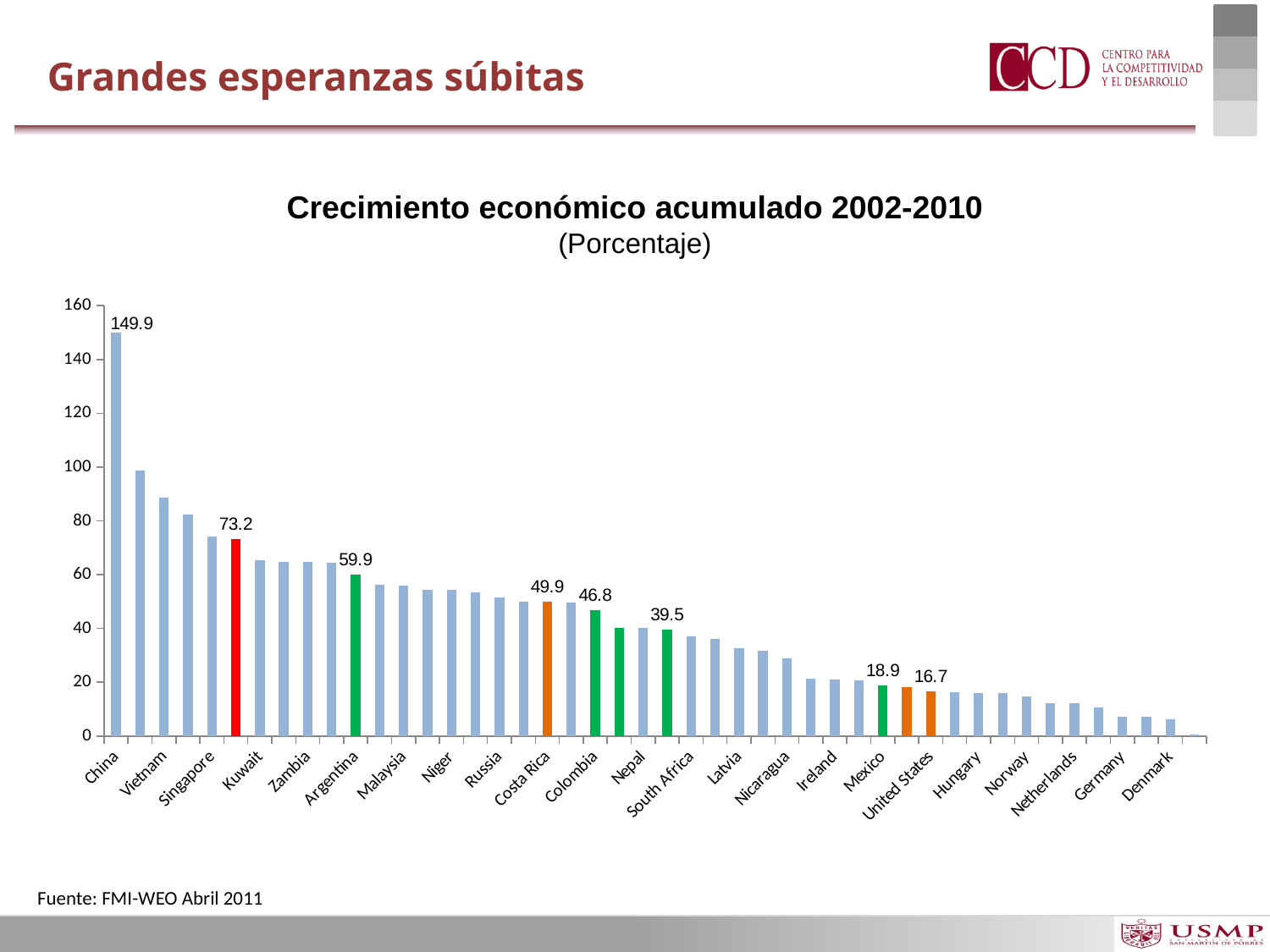
Which has a larger value, Argentina or Colombia? Argentina Is the value for Vietnam greater or less than 80? greater What is the value shown for Argentina? 59.9 Do the values generally rise or fall from left to right along the x axis? Fall What is the title of the chart? Crecimiento económico acumulado 2002-2010 (Porcentaje) What is the difference between the values for Colombia and Mexico? 27.9 What is the value shown for China? 149.9 What is the value shown for Costa Rica? 49.9 Which country has the highest cumulative economic growth in the chart? China What is the value shown for United States? 16.7 What type of chart is shown on the slide? Bar chart What value is labelled on the red bar? 73.2